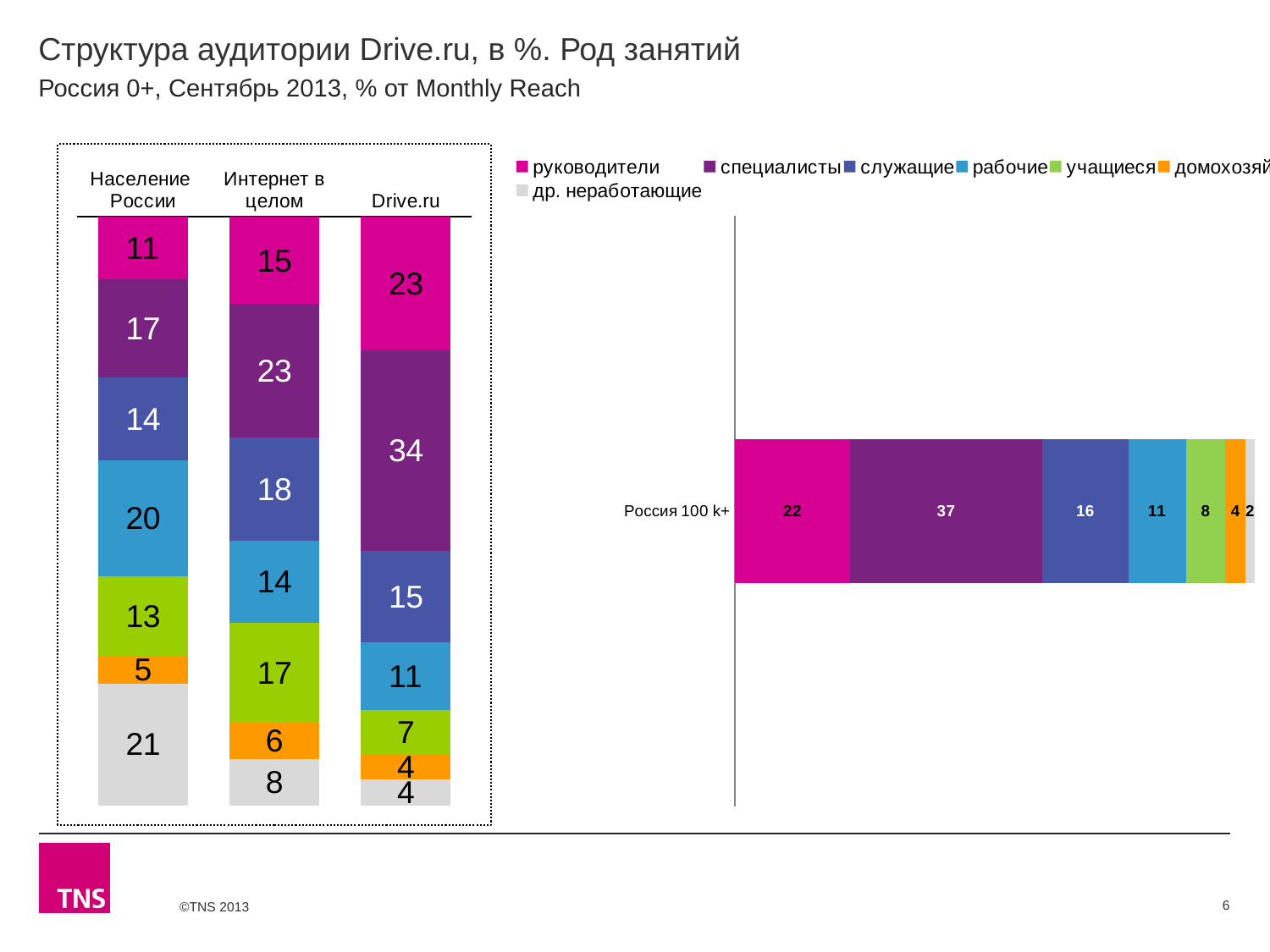
In the left chart, which bar has the smallest др. неработающие segment? Drive.ru In the left chart, what is the value of the рабочие segment for Интернет в целом? 14 In the left chart, what is the value of the специалисты segment for Drive.ru? 34 In the left chart, what is the difference between the руководители values for Drive.ru and Население России? 12 How many series does the legend list? 7 In the left chart, what is the value of the руководители segment for Население России? 11 In the left chart, which bar has the largest специалисты segment? Drive.ru In the right chart (Россия 100 k+), what is the value of the учащиеся segment? 8 How many bars does the left chart show? 3 What type of chart is the right chart (Россия 100 k+)? Stacked bar chart In the right chart (Россия 100 k+), what is the value of the специалисты segment? 37 In the left chart, is the учащиеся value larger for Население России or for Интернет в целом? Интернет в целом